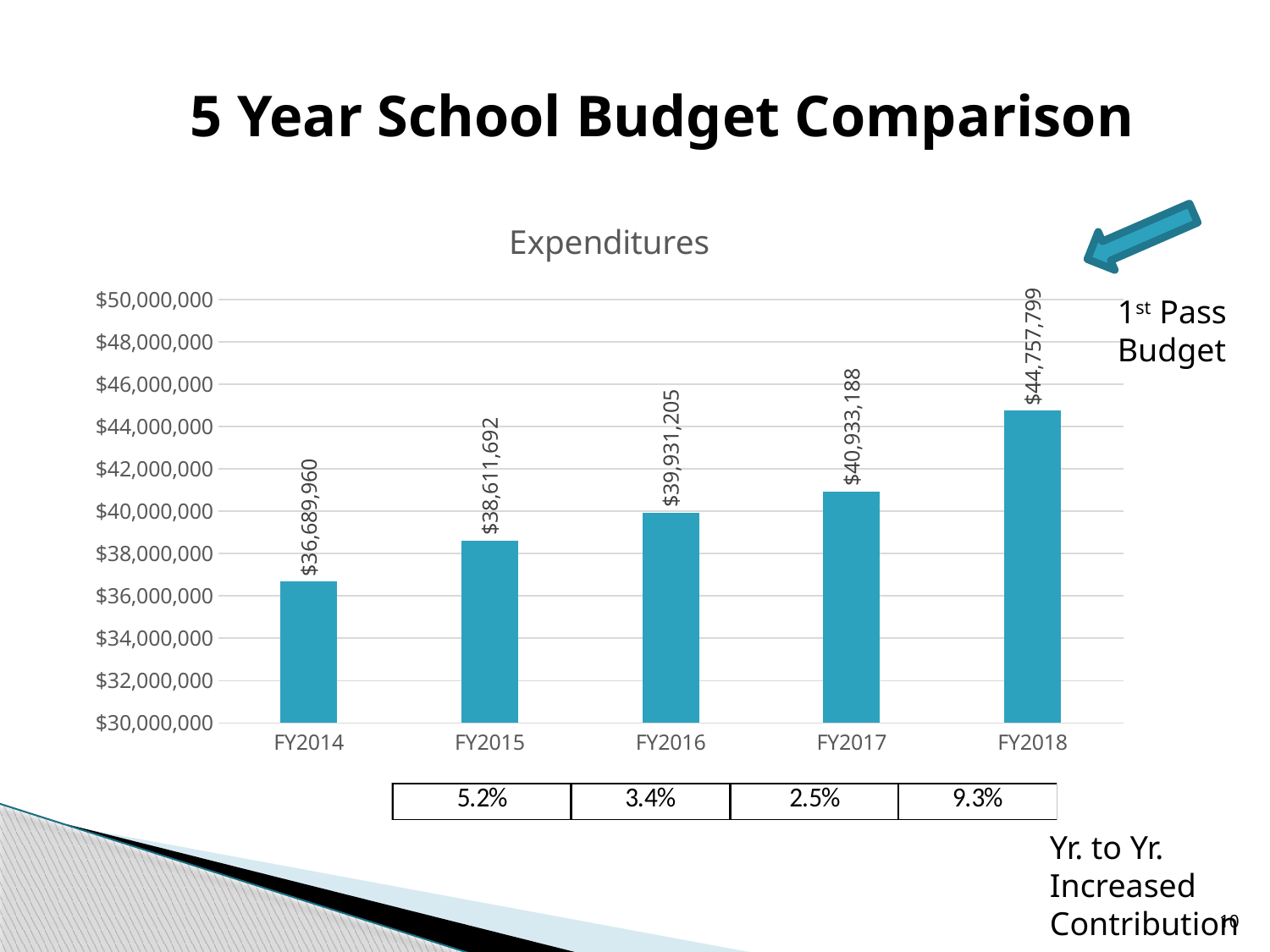
What is the difference between the FY2015 and FY2014 expenditures? $1,921,732 What is the difference between the FY2018 and FY2017 expenditures? $3,824,611 Which fiscal year has the lowest expenditure? FY2014 What is the expenditure value for FY2017? $40,933,188 What is the expenditure value for FY2014? $36,689,960 Which fiscal year has the highest expenditure? FY2018 Which is larger, the expenditure for FY2016 or FY2015? FY2016 Do the expenditures rise or fall from FY2014 to FY2018? rise Is the expenditure for FY2017 greater or less than $40,000,000? greater How many fiscal years are shown in the chart? 5 What is the expenditure value for FY2018? $44,757,799 What type of chart is used to show the expenditures? bar chart